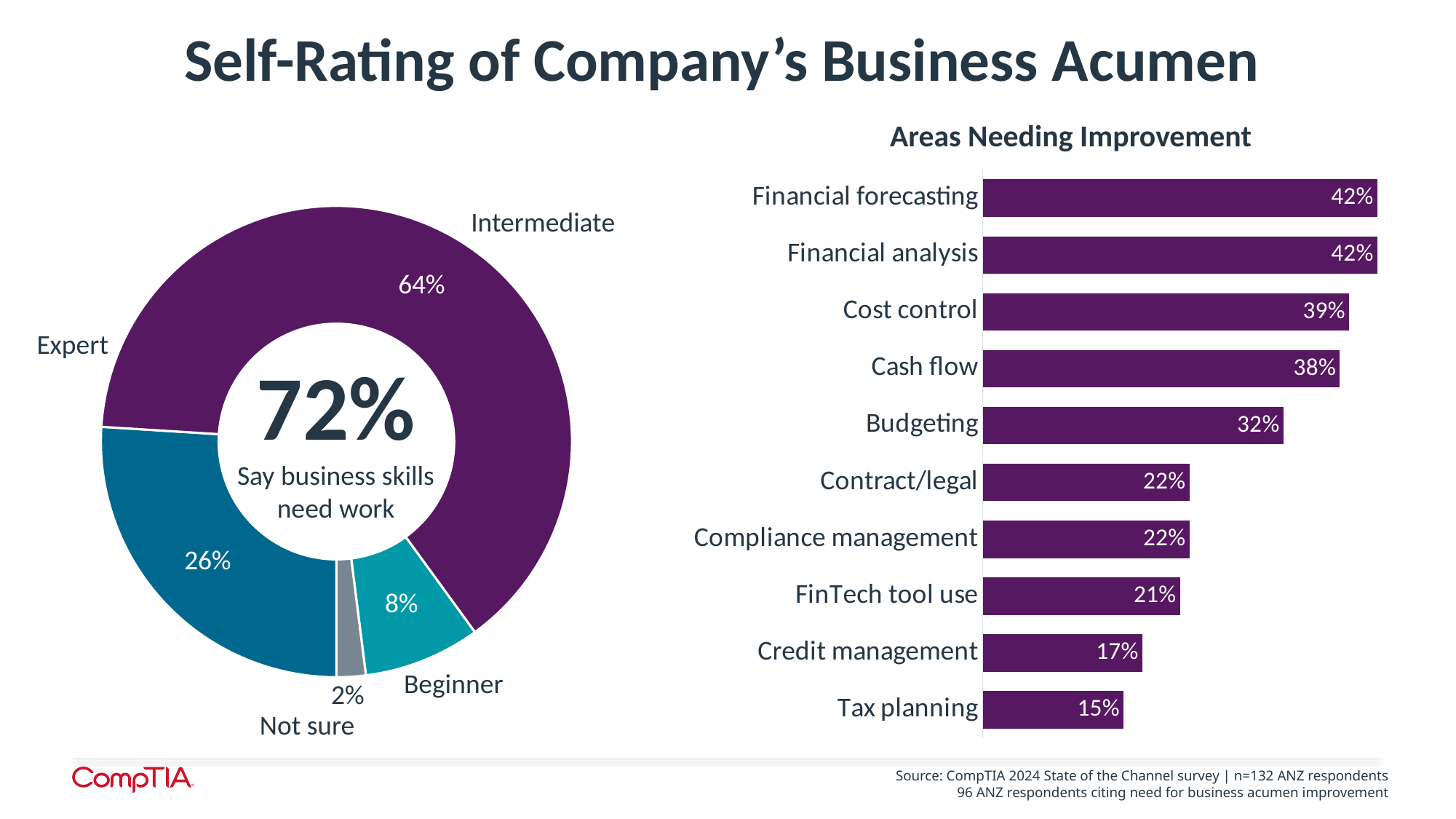
In the donut chart on the left, what percentage rated their company as Expert? 26% In the donut chart on the left, which category has the smallest share? Not sure In the donut chart on the left, what percentage of respondents rated their company's business acumen as Intermediate? 64% In the Areas Needing Improvement chart, what is the value for Cost control? 39% In the Areas Needing Improvement chart, what is the value for Tax planning? 15% In the Areas Needing Improvement chart, which area has the lowest value? Tax planning In the donut chart on the left, what figure is printed in the centre? 72% In the Areas Needing Improvement chart, what is the difference between Budgeting and Credit management? 15 percentage points In the donut chart on the left, what is the difference between the Intermediate and Expert shares? 38 percentage points In the Areas Needing Improvement chart, which is larger: Cash flow or Budgeting? Cash flow In the donut chart on the left, how many categories are shown? 4 In the Areas Needing Improvement chart, how many areas are listed? 10